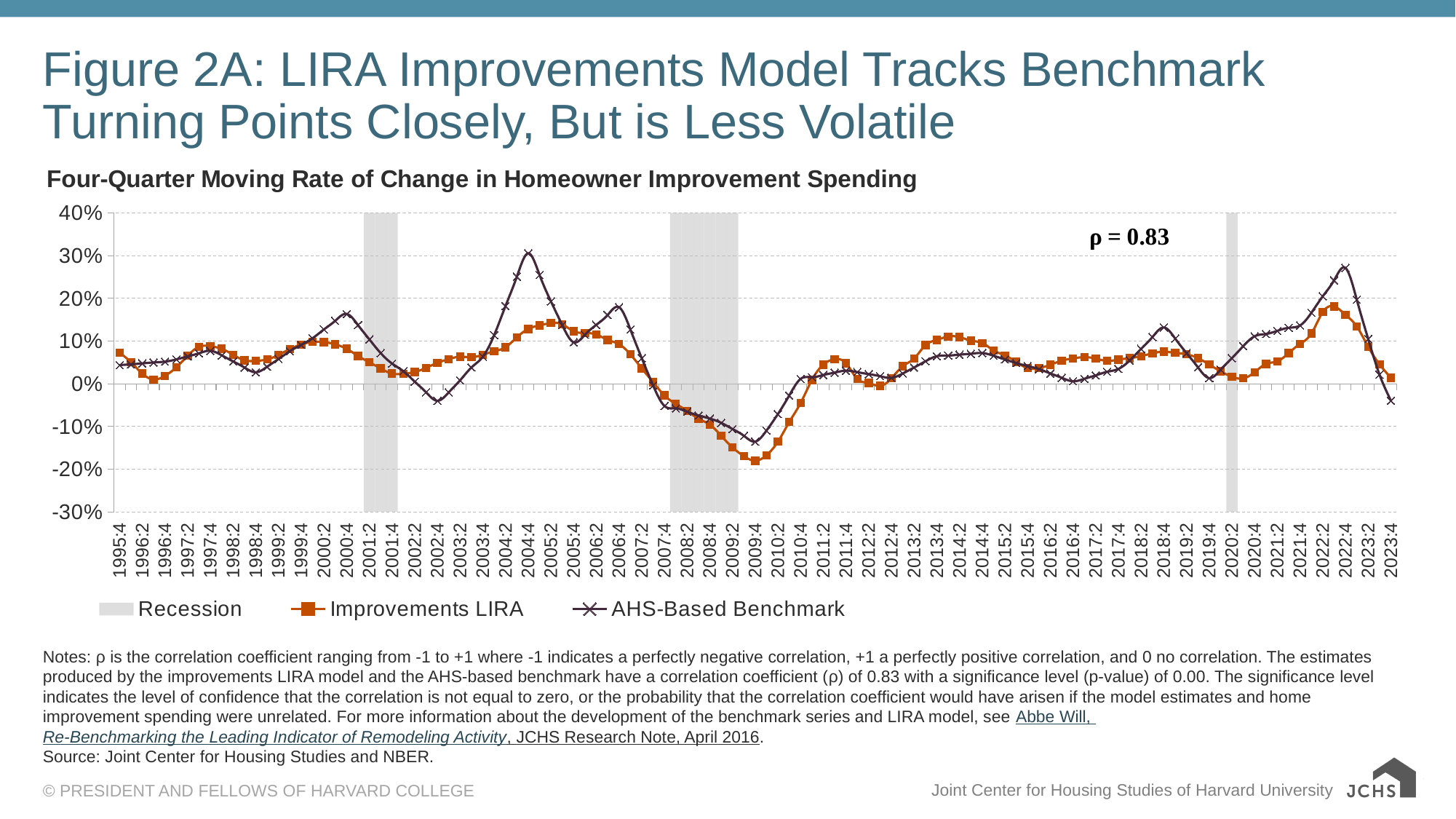
Does the Improvements LIRA series rise or fall between 2007:2 and 2009:4? Fall How many entries does the chart legend list? 3 Is the AHS-Based Benchmark value at 2004:4 greater or less than 20%? greater Which series reaches the highest peak on the chart? AHS-Based Benchmark At 2004:4, which series has the higher value, Improvements LIRA or AHS-Based Benchmark? AHS-Based Benchmark Is the AHS-Based Benchmark value at 2002:4 greater or less than 0%? less What kind of chart is shown on the slide? Line chart Is the AHS-Based Benchmark value at 2022:4 greater or less than 20%? greater What is the correlation coefficient (ρ) printed on the chart? ρ = 0.83 What is the subtitle printed above the chart? Four-Quarter Moving Rate of Change in Homeowner Improvement Spending At 2009:4, which series has the lower value, Improvements LIRA or AHS-Based Benchmark? Improvements LIRA